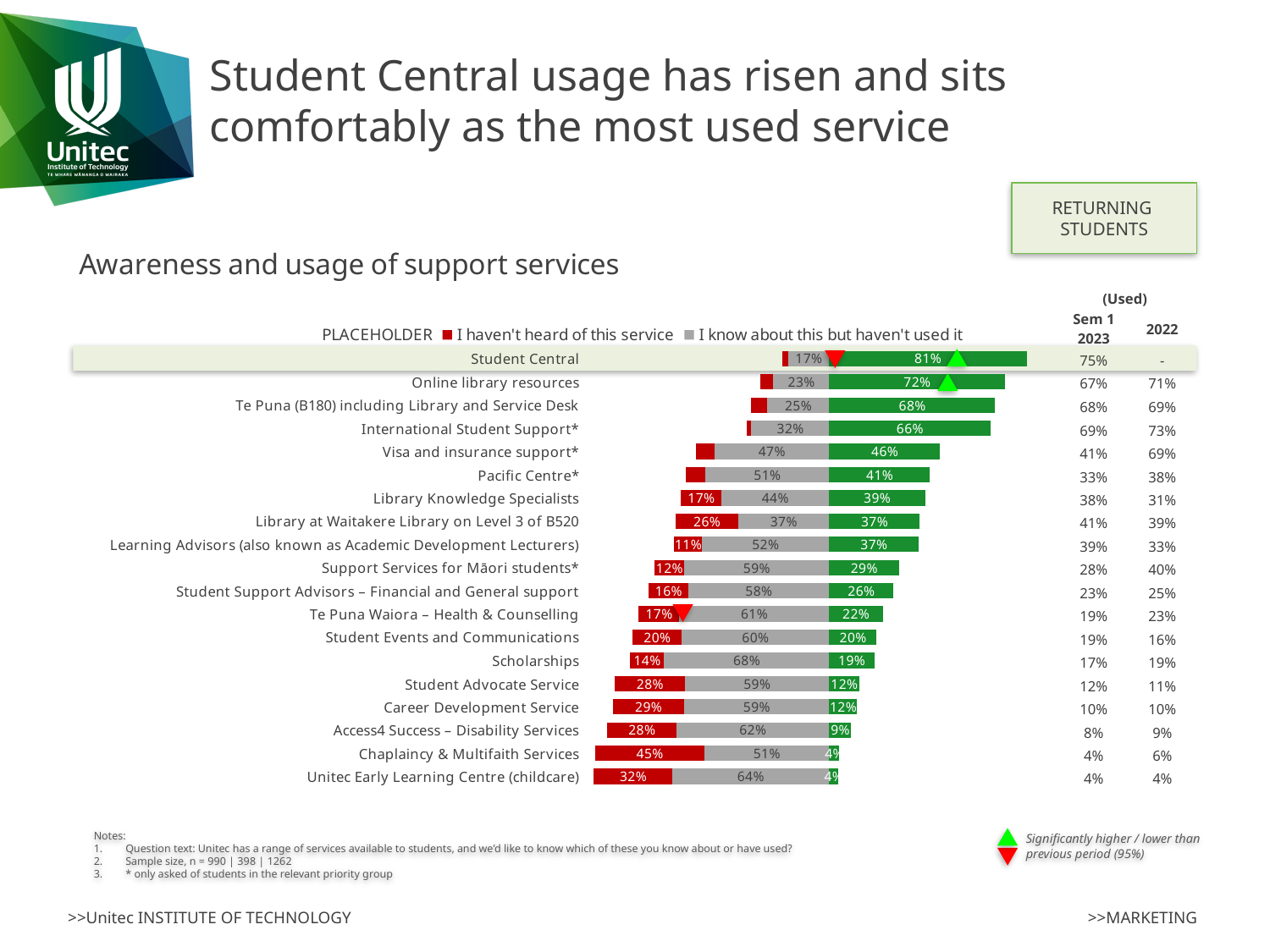
How many series does the chart legend list? 3 How many support services (categories) are listed in the chart? 19 What colour represents 'I haven't heard of this service' in the chart? Red What kind of chart is shown on the slide? Stacked horizontal bar chart What is the difference between the green (used) values for Student Central and Online library resources? 9 percentage points What is the 'I haven't heard of this service' value for Chaplaincy & Multifaith Services? 45% Which has the larger green (used) value: Visa and insurance support or Pacific Centre? Visa and insurance support Which service has the highest 'I haven't heard of this service' value? Chaplaincy & Multifaith Services What is the 'I know about this but haven't used it' value for Scholarships? 68% Which service has the highest green (used) value? Student Central What is the 'I know about this but haven't used it' value for Te Puna Waiora – Health & Counselling? 61% What is the green (used) value for Student Central? 81%